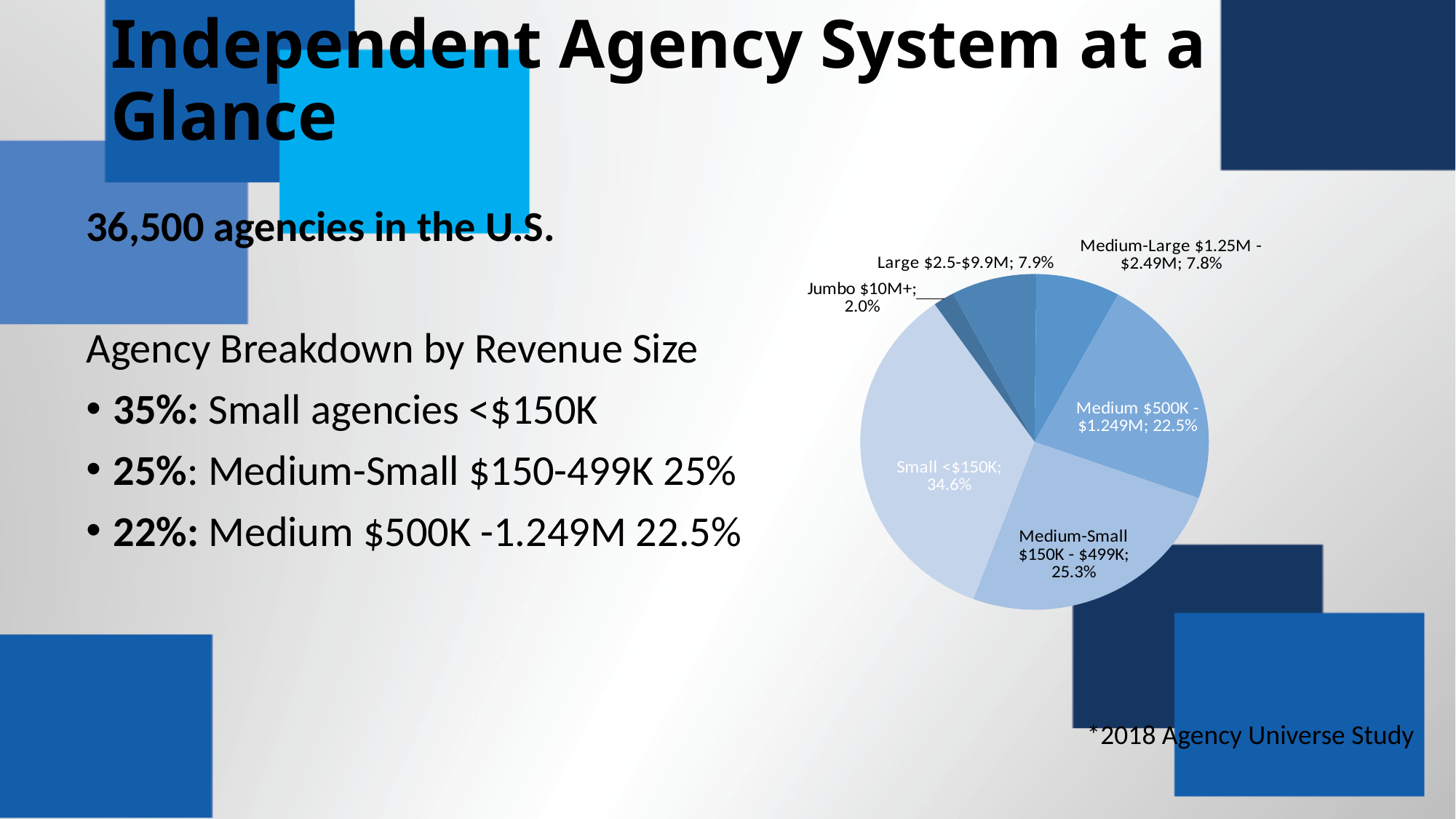
How many slices does the pie chart have? 6 What percentage is shown for Medium $500K - $1.249M agencies? 22.5% What is the difference in percentage points between the Large $2.5-$9.9M slice and the Medium-Large $1.25M - $2.49M slice? 0.1 Which revenue-size category has the smallest slice of the pie? Jumbo $10M+ What percentage is shown for Large $2.5-$9.9M agencies? 7.9% What kind of chart is shown on the slide? Pie chart What percentage is shown for Medium-Small $150K - $499K agencies? 25.3% What share of the pie is labelled for Small <$150K agencies? 34.6% What is the difference in percentage points between the Small <$150K slice and the Medium-Small $150K - $499K slice? 9.3 Which revenue-size category has the largest slice of the pie? Small <$150K Which slice is larger: Medium $500K - $1.249M or Medium-Large $1.25M - $2.49M? Medium $500K - $1.249M What percentage is shown for Jumbo $10M+ agencies? 2.0%